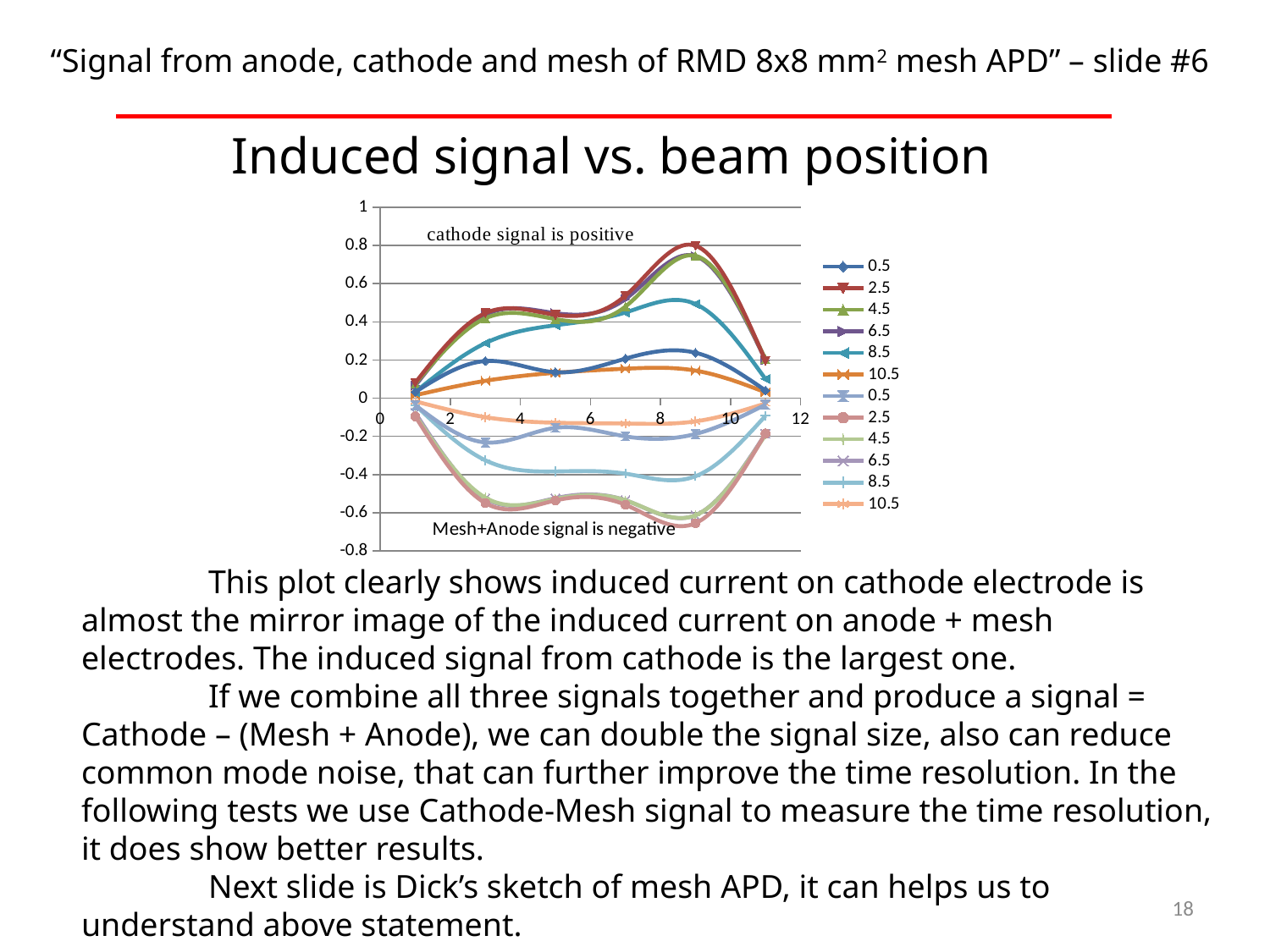
Is the value of the upper 8.5 series at x = 8 greater or less than 0.2? greater Is the value of the lower 6.5 series at x = 4 greater or less than -0.4? less According to the annotation in the upper part of the chart, which signal is positive? cathode signal What is the title of the chart? Induced signal vs. beam position How many series does the legend of the chart list? 12 What kind of chart is shown on the slide? line chart Is the value of the upper 0.5 series at x = 2 greater or less than 0.4? less